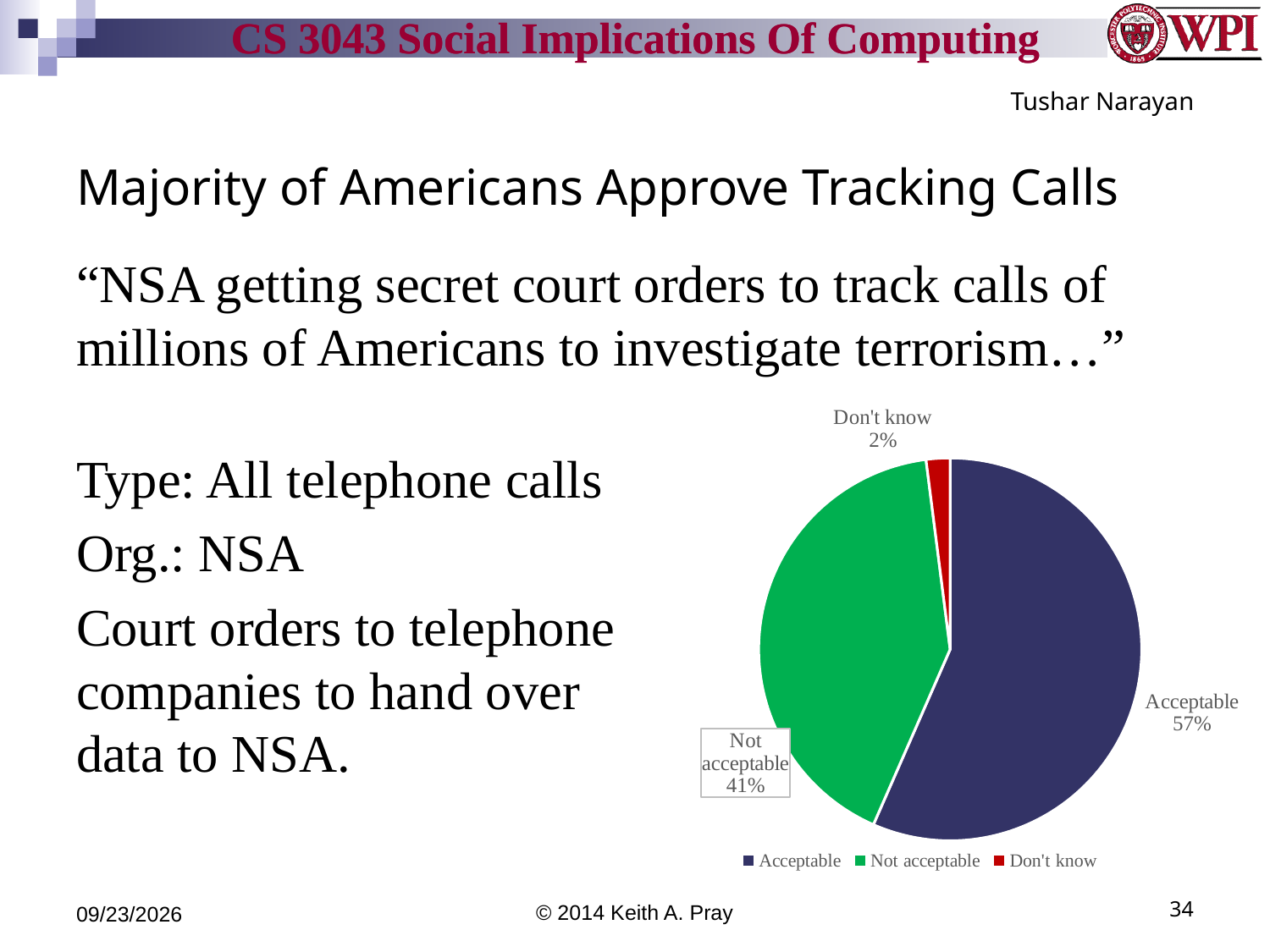
Which is larger, the Not acceptable slice or the Don't know slice? Not acceptable How many slices does the pie chart have? 3 Which slice of the pie is the smallest? Don't know Which slice of the pie is the largest? Acceptable What colour is the Acceptable slice in the pie chart? dark blue What share of the pie is labelled Acceptable? 57% How many entries does the legend list? 3 What share of the pie is labelled Don't know? 2% What colour is the Don't know slice in the pie chart? red What kind of chart is shown on the slide? pie chart What is the difference in percentage points between the Acceptable and Not acceptable slices? 16 What share of the pie is labelled Not acceptable? 41%